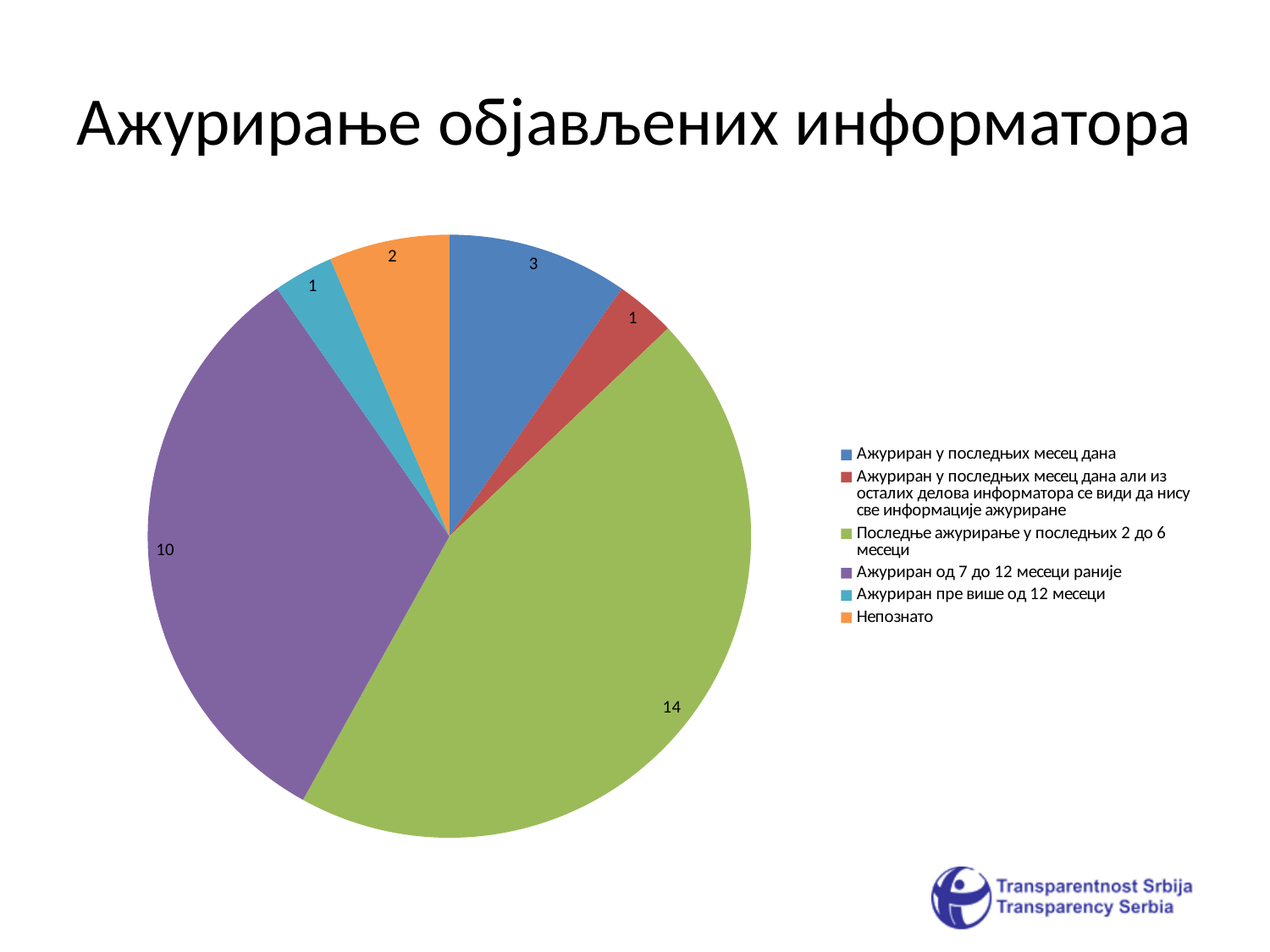
What kind of chart is shown on the slide? pie chart How many entries does the legend list? 6 What is the value for the slice 'Непознато'? 2 What is the value for the slice 'Ажуриран пре више од 12 месеци'? 1 How many slices does the pie chart have? 6 What is the difference between the values for 'Последње ажурирање у последњих 2 до 6 месеци' and 'Ажуриран од 7 до 12 месеци раније'? 4 What is the value for the slice 'Ажуриран од 7 до 12 месеци раније'? 10 What is the title of the slide containing the pie chart? Ажурирање објављених информатора What is the value for the slice 'Последње ажурирање у последњих 2 до 6 месеци'? 14 What is the value for the slice 'Ажуриран у последњих месец дана'? 3 Which category has the largest slice of the pie? Последње ажурирање у последњих 2 до 6 месеци Which is larger: the value for 'Ажуриран у последњих месец дана' or the value for 'Непознато'? Ажуриран у последњих месец дана